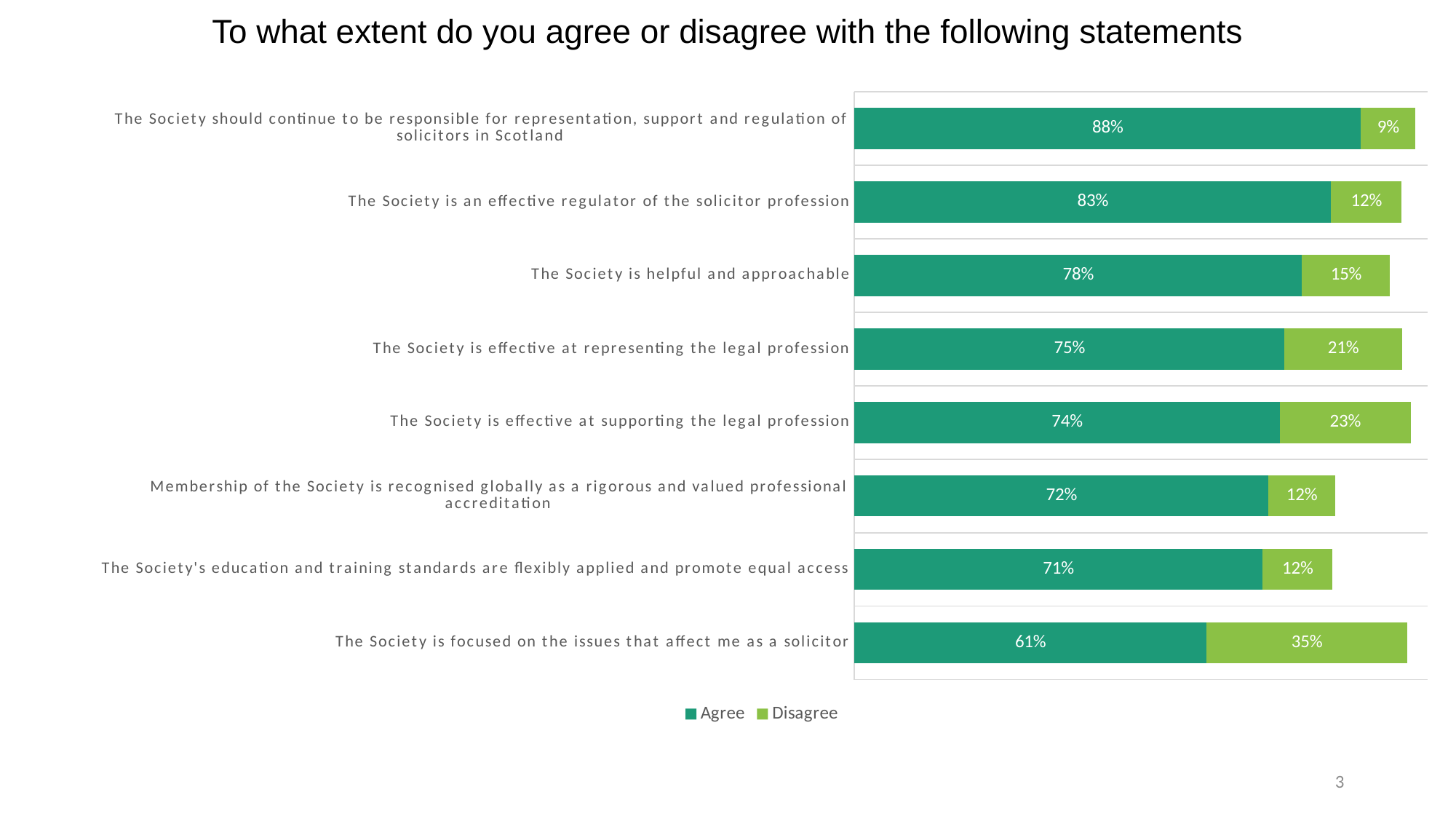
Which statement has the lowest Agree percentage? The Society is focused on the issues that affect me as a solicitor How many series does the legend list? 2 Which statement has the lowest Disagree percentage? The Society should continue to be responsible for representation, support and regulation of solicitors in Scotland What percentage agree that the Society is helpful and approachable? 78% What is the combined Agree and Disagree total for 'The Society is focused on the issues that affect me as a solicitor'? 96% What percentage disagree that the Society is focused on the issues that affect me as a solicitor? 35% What is the difference between the Agree and Disagree percentages for 'The Society is effective at supporting the legal profession'? 51% How many statements are shown in the chart? 8 What is the Agree value for 'The Society is an effective regulator of the solicitor profession'? 83% Which has a higher Disagree percentage: 'The Society is effective at representing the legal profession' or 'The Society is helpful and approachable'? The Society is effective at representing the legal profession Which statement has the highest Agree percentage? The Society should continue to be responsible for representation, support and regulation of solicitors in Scotland What type of chart is shown on the slide? Stacked bar chart